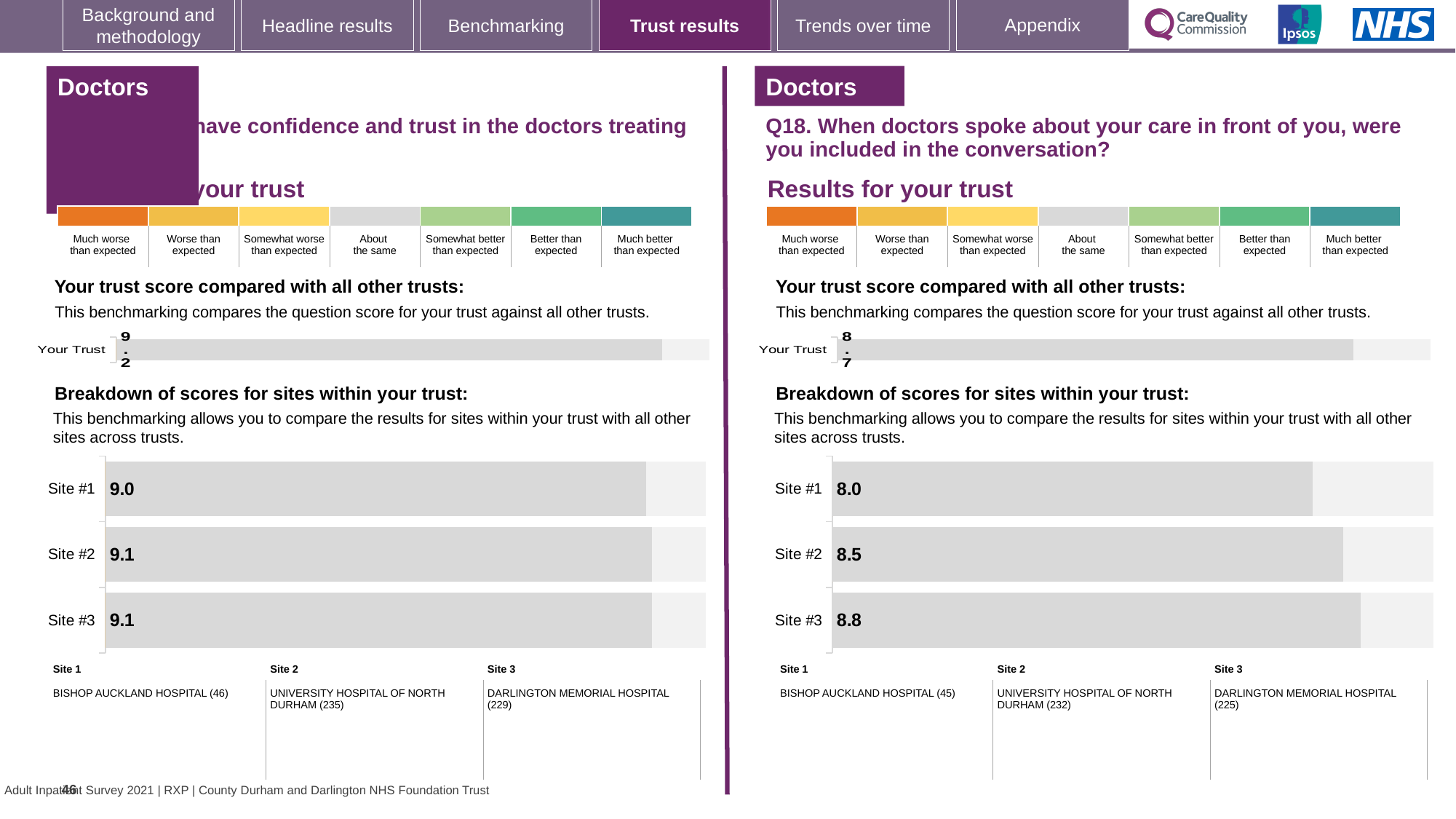
On the right-hand (Q18) site breakdown chart, how many sites are shown? 3 On the right-hand (Q18) 'Breakdown of scores for sites within your trust' chart, what is the score for Site #1? 8.0 On the right-hand (Q18) site breakdown chart, which site has the highest score? Site #3 On the right-hand (Q18) 'Breakdown of scores for sites within your trust' chart, what is the score for Site #3? 8.8 On the right-hand (Q18) 'Your trust score compared with all other trusts' chart, what is the value shown for Your Trust? 8.7 On the left-hand 'Your trust score compared with all other trusts' chart, what is the value shown for Your Trust? 9.2 On the left-hand 'Breakdown of scores for sites within your trust' chart, what is the score for Site #1? 9.0 On the left-hand site breakdown chart, which site has the lowest score? Site #1 On the right-hand (Q18) site breakdown chart, which site has the lowest score? Site #1 What type of chart is used for the site breakdown on the left-hand side of the slide? Bar chart On the right-hand (Q18) site breakdown chart, what is the difference between the scores for Site #3 and Site #1? 0.8 On the left-hand 'Breakdown of scores for sites within your trust' chart, what is the score for Site #2? 9.1